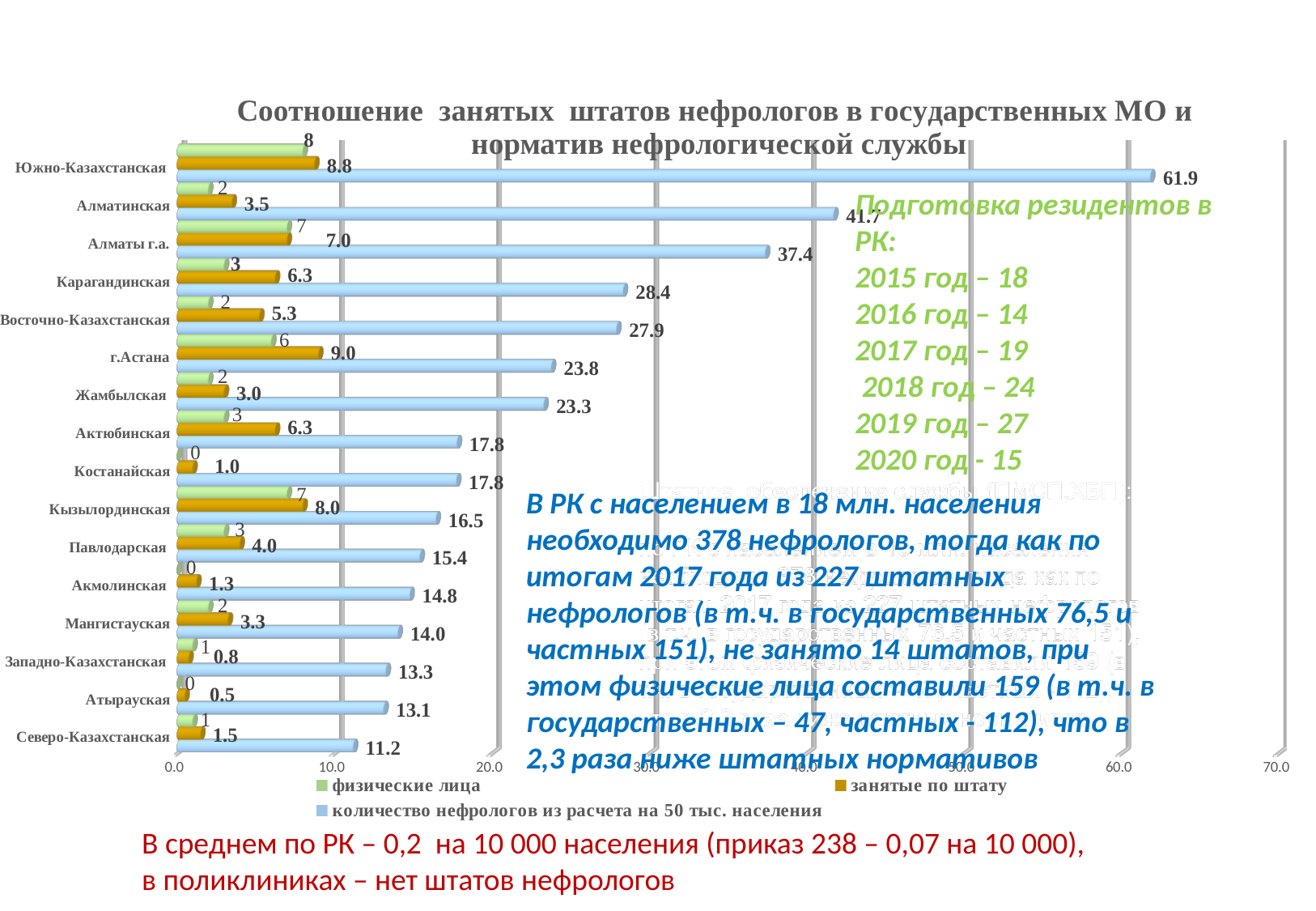
Which region has the lowest value for 'количество нефрологов из расчета на 50 тыс. населения'? Северо-Казахстанская Is the value of 'количество нефрологов из расчета на 50 тыс. населения' for Алматы г.а. greater or less than 30.0? greater What is the value of 'занятые по штату' for г.Астана? 9.0 Which series is shown in blue in the chart legend? количество нефрологов из расчета на 50 тыс. населения How many series does the chart legend list? 3 What type of chart is shown on the slide? bar chart Which region has the highest value for 'количество нефрологов из расчета на 50 тыс. населения'? Южно-Казахстанская How many regions (categories) are plotted on the chart? 16 What is the value of 'физические лица' for Кызылординская? 7 Which is larger: 'занятые по штату' for Карагандинская or for Павлодарская? Карагандинская What is the difference between the 'количество нефрологов из расчета на 50 тыс. населения' values for Южно-Казахстанская and Алматинская? 20.2 What is the value of 'количество нефрологов из расчета на 50 тыс. населения' for Южно-Казахстанская? 61.9